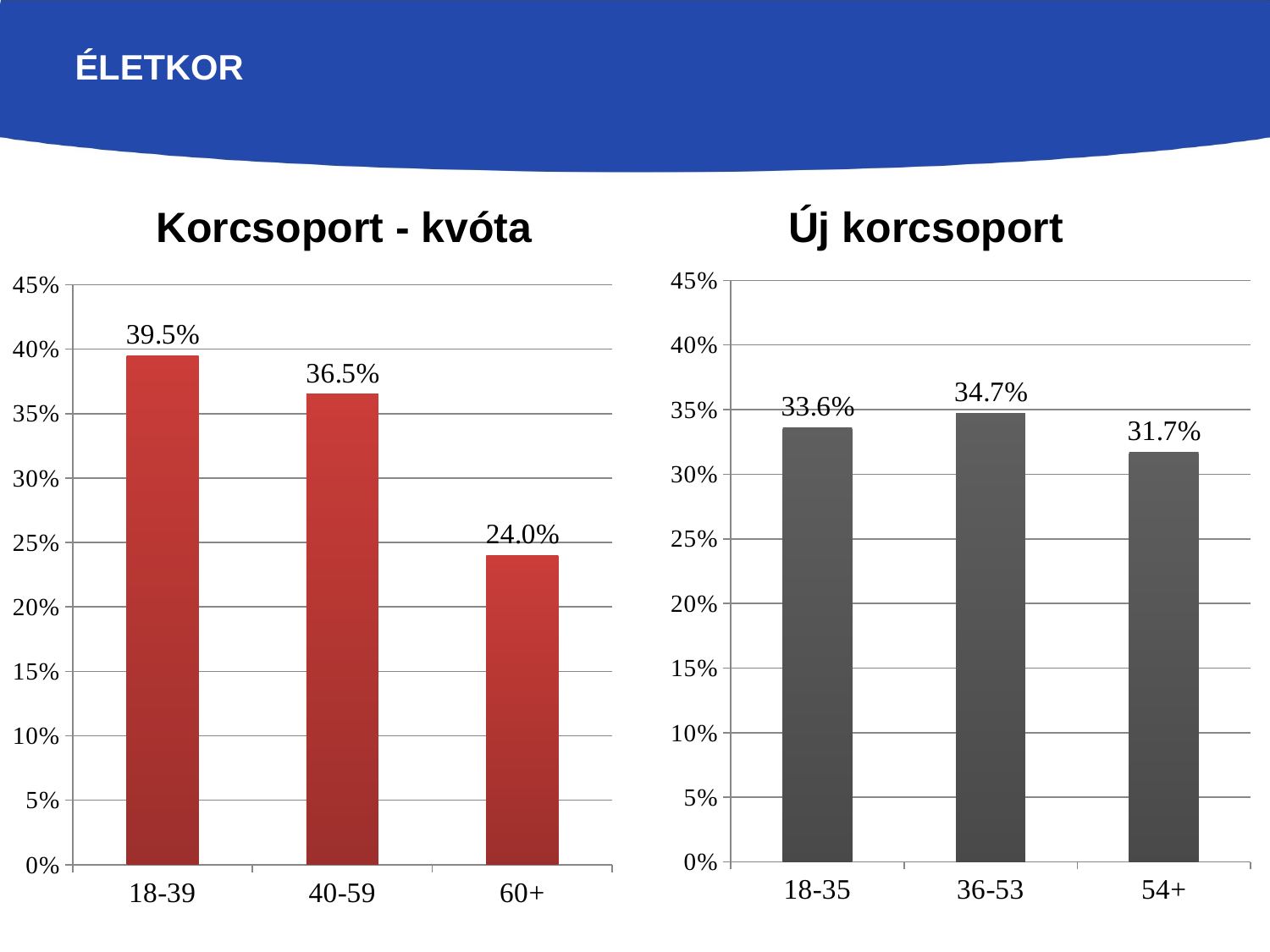
In the 'Új korcsoport' chart, what is the value for 36-53? 34.7% In the 'Korcsoport - kvóta' chart, what is the difference between the values for 18-39 and 60+? 15.5% In the 'Korcsoport - kvóta' chart, do the values rise or fall from left to right along the x axis? fall In the 'Korcsoport - kvóta' chart, what is the value for 60+? 24.0% In the 'Korcsoport - kvóta' chart, which category has the highest value? 18-39 What kind of chart is the 'Korcsoport - kvóta' chart? bar chart How many categories does the 'Új korcsoport' chart show? 3 In the 'Korcsoport - kvóta' chart, what is the value for 18-39? 39.5% In the 'Korcsoport - kvóta' chart, which is larger, the value for 40-59 or the value for 60+? 40-59 In the 'Új korcsoport' chart, what is the value for 54+? 31.7% In the 'Új korcsoport' chart, which category has the lowest value? 54+ In the 'Új korcsoport' chart, what is the difference between the values for 36-53 and 18-35? 1.1%